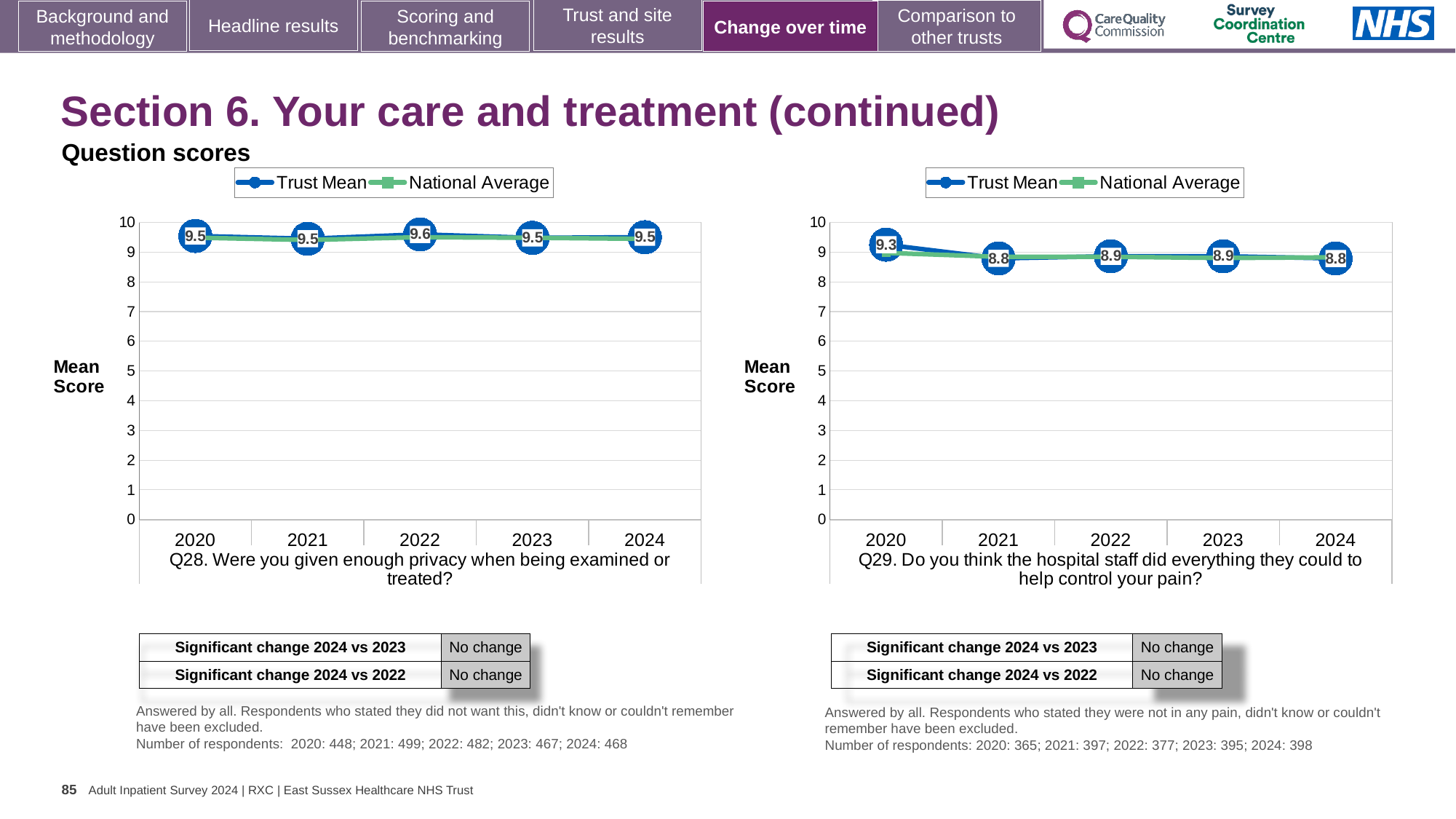
In the Q28 chart (left), is the Trust Mean score for 2021 greater or less than 9? greater How many series does the legend of the Q29 chart (right) list? 2 In the Q28 chart (left), what is the Trust Mean score for 2024? 9.5 In the Q28 chart (left), what is the Trust Mean score for 2022? 9.6 In the Q29 chart (right), what is the Trust Mean score for 2023? 8.9 In the Q29 chart (right), which year has the highest Trust Mean score? 2020 In the Q29 chart (right), what is the Trust Mean score for 2020? 9.3 In the Q28 chart (left), which year has the highest Trust Mean score? 2022 In the Q29 chart (right), what is the difference between the Trust Mean score in 2020 and in 2024? 0.5 How many years are plotted on the x axis of the Q28 chart (left)? 5 In the Q29 chart (right), is the Trust Mean score for 2020 larger or smaller than the score for 2021? larger What type of chart is used for Q29 (right)? Line chart